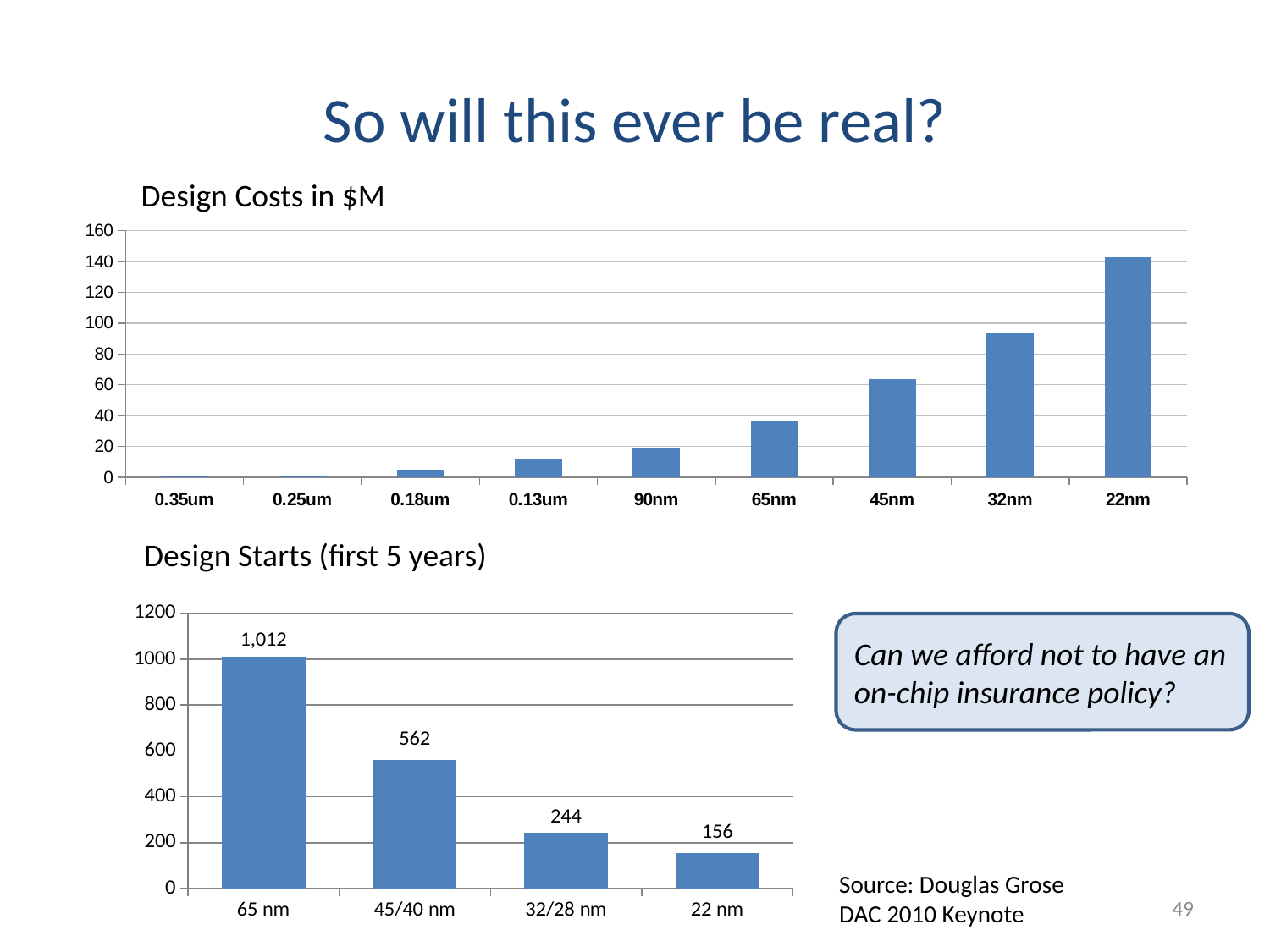
What kind of chart is the Design Costs in $M chart? bar chart In the Design Starts (first 5 years) chart, how many process nodes are shown? 4 In the Design Costs in $M chart, how many process nodes are shown on the x axis? 9 In the Design Starts (first 5 years) chart, do the values rise or fall from 65 nm to 22 nm? fall In the Design Costs in $M chart, is the value for 22nm greater or less than 120? greater In the Design Starts (first 5 years) chart, which process node has the highest number of design starts? 65 nm In the Design Starts (first 5 years) chart, what is the difference between the values for 65 nm and 45/40 nm? 450 In the Design Starts (first 5 years) chart, which process node has the lowest number of design starts? 22 nm In the Design Starts (first 5 years) chart, what is the value for 65 nm? 1,012 In the Design Starts (first 5 years) chart, what is the value for 32/28 nm? 244 In the Design Starts (first 5 years) chart, what is the value for 22 nm? 156 In the Design Costs in $M chart, is the value for 32nm greater or less than 100? less